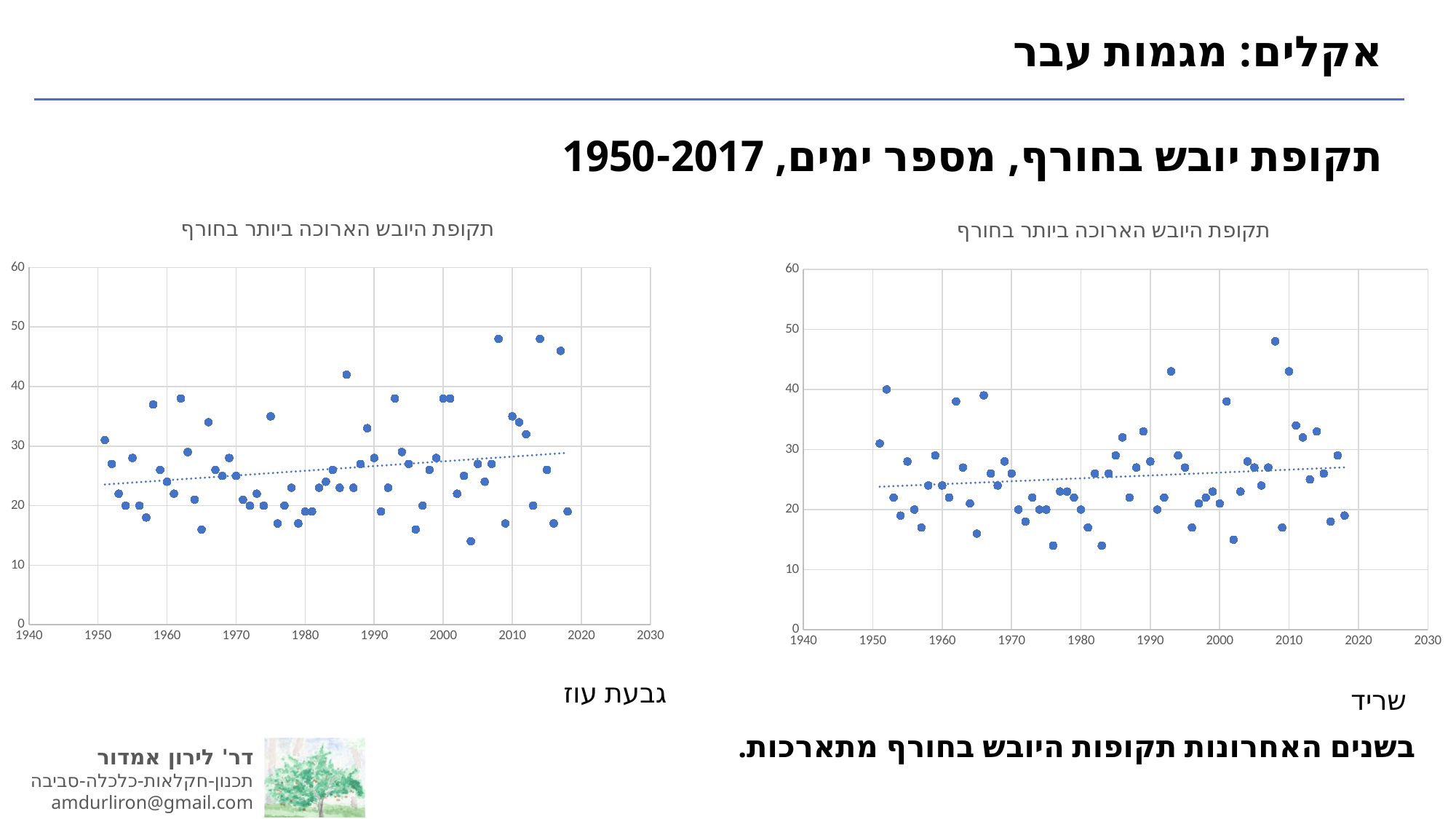
What kind of chart is the left chart (גבעת עוז)? scatter chart In the left chart (גבעת עוז), is the value for 1986 greater or less than 40? greater In the left chart (גבעת עוז), does the dotted trend line rise or fall from 1950 to 2017? rises In the right chart (שריד), does the dotted trend line rise or fall from 1950 to 2017? rises What is the maximum value shown on the y axis of the left chart (גבעת עוז)? 60 In the right chart (שריד), is the value for 2008 greater or less than 40? greater What kind of chart is the right chart (שריד)? scatter chart In the right chart (שריד), which year has the highest value? 2008 In the left chart (גבעת עוז), is the value for 2008 greater or less than 40? greater What is the title shown above each of the two charts? תקופת היובש הארוכה ביותר בחורף